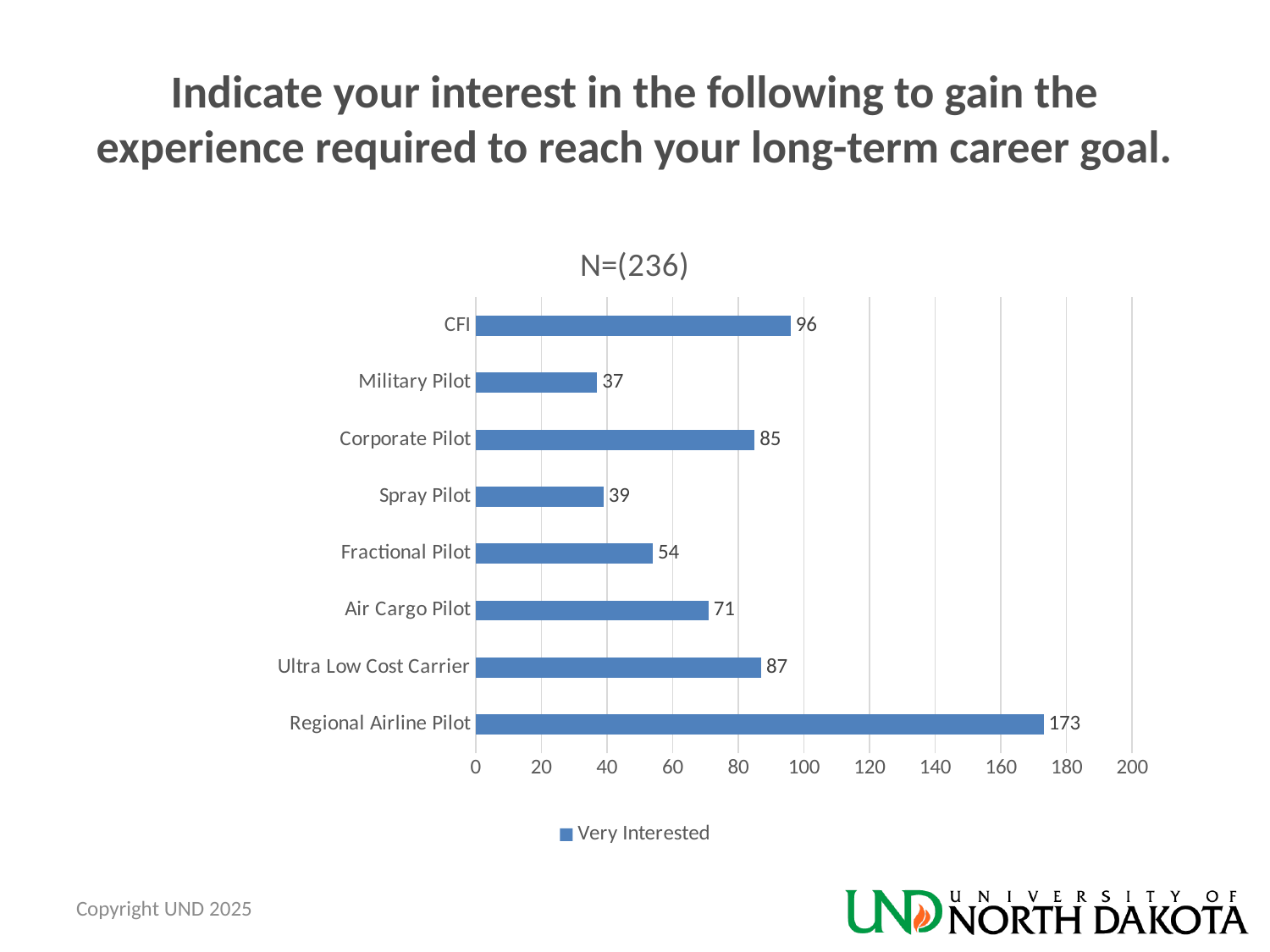
What is the value for CFI? 96 Which is larger, the value for Corporate Pilot or the value for Air Cargo Pilot? Corporate Pilot Which category has the highest value? Regional Airline Pilot What is the difference between the values for Regional Airline Pilot and CFI? 77 What is the chart's title? N=(236) What is the value for Military Pilot? 37 What kind of chart is shown on the slide? bar chart What is the value for Ultra Low Cost Carrier? 87 How many series does the legend list? 1 Which category has the lowest value? Military Pilot Is the value for Fractional Pilot greater or less than 60? less How many categories are shown in the chart? 8